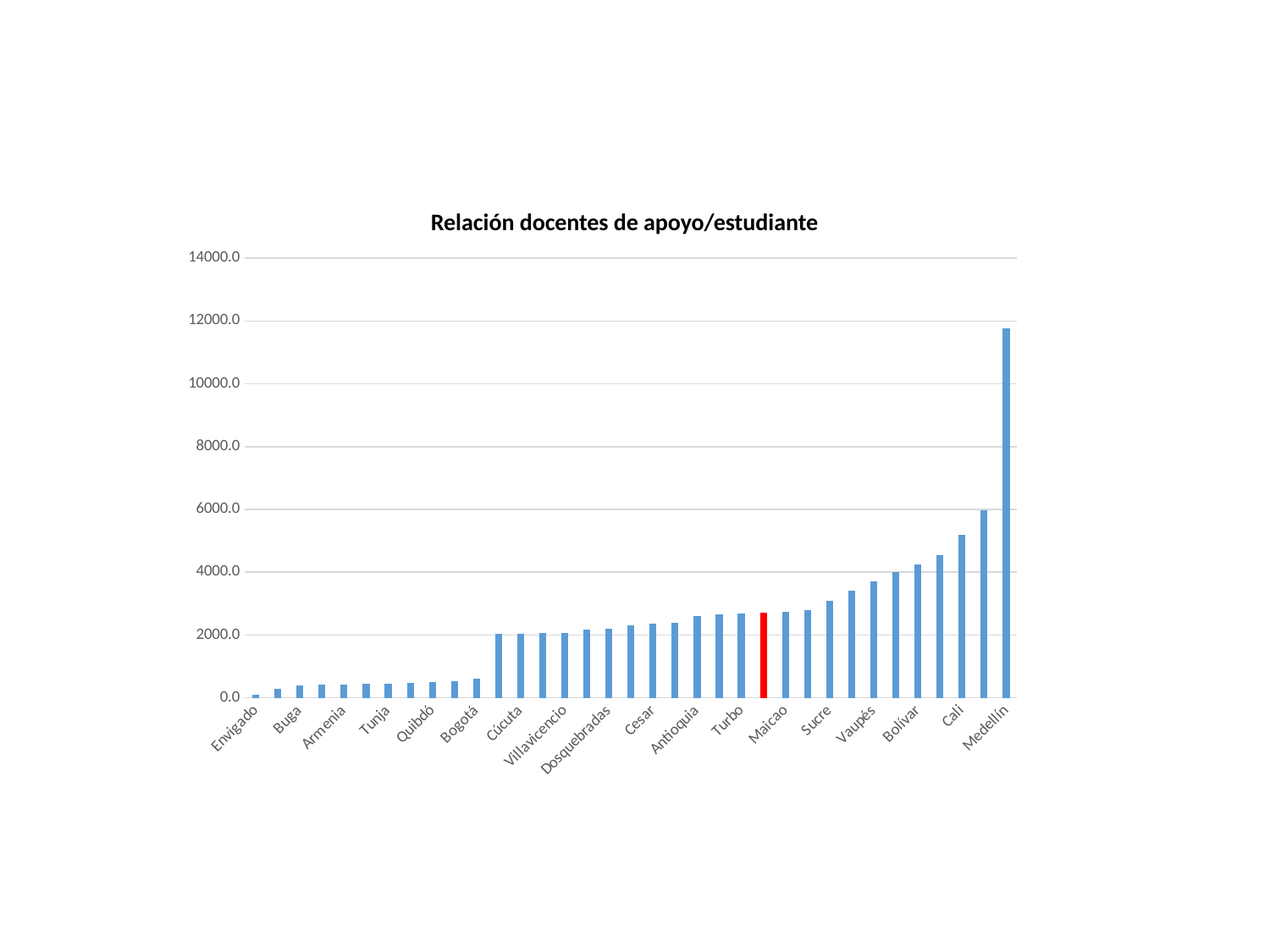
Is the value for Bogotá greater or less than 2000? less Which category has the lowest value in the chart? Envigado What is the title of the chart? Relación docentes de apoyo/estudiante Is the value for Envigado greater or less than 2000? less Which is larger, the value for Cúcuta or the value for Bogotá? Cúcuta Which category has the highest value in the chart? Medellín Which is larger, the value for Medellín or the value for Cali? Medellín Is the value for Cali greater or less than 4000? greater What kind of chart is shown on the slide? bar chart Do the values generally rise or fall from left to right along the x axis? rise What colour is the single bar that is highlighted differently from the others? red